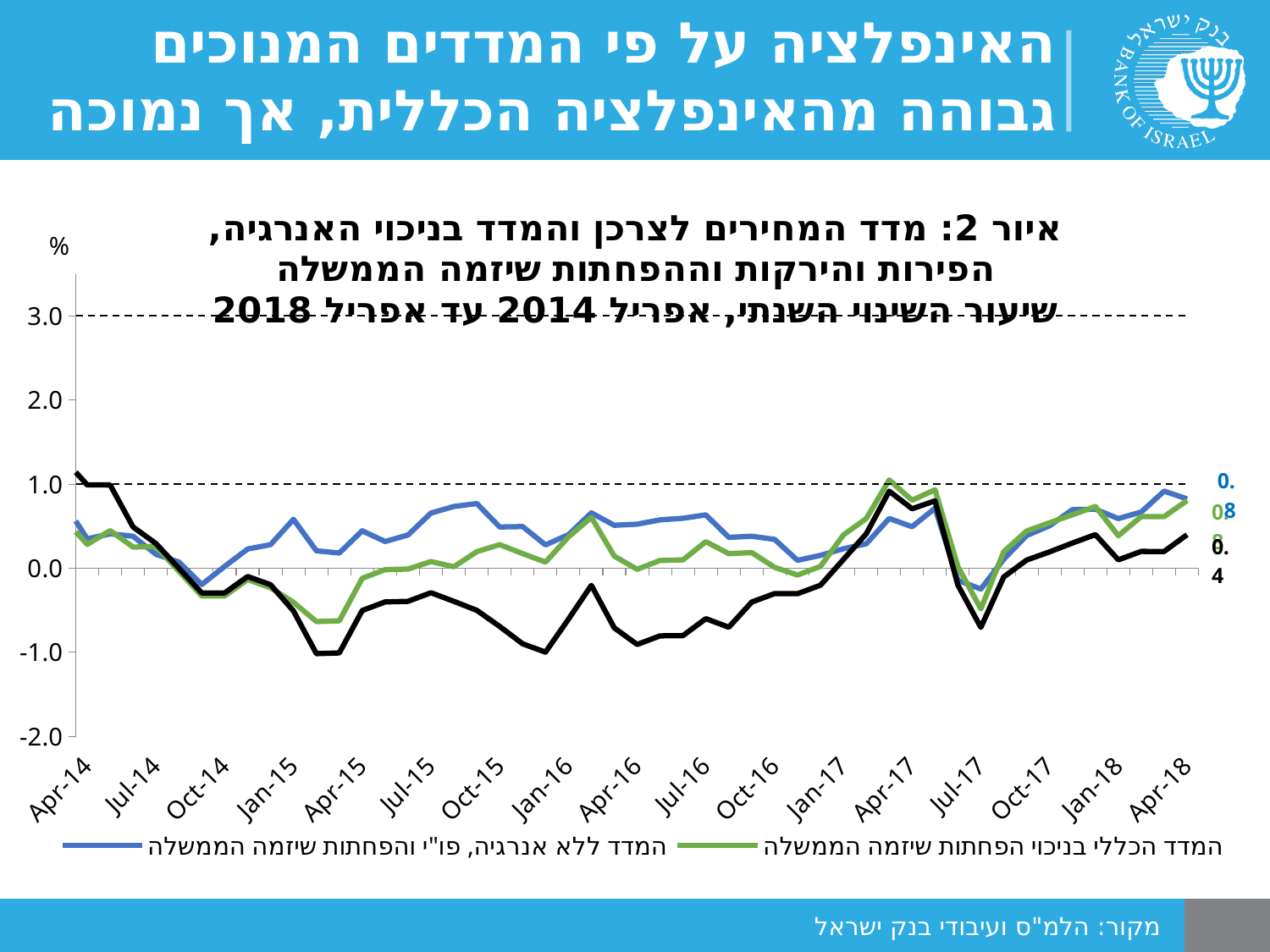
What unit is shown on the vertical axis of the chart? % Does the black line rise or fall between Apr-14 and Apr-15? fall At Apr-18, which line is higher, the blue line or the black line? the blue line Is the value of the blue line at Apr-18 greater or less than 1.0? less At which two values are horizontal dashed lines drawn on the chart? 1.0 and 3.0 Is the value of the blue line at Oct-15 greater or less than 0.0? greater How many series does the legend list? 2 What kind of chart is shown on the slide? line chart Is the value of the black line at Jul-17 greater or less than 0.0? less At Apr-14, which line is higher, the black line or the blue line? the black line